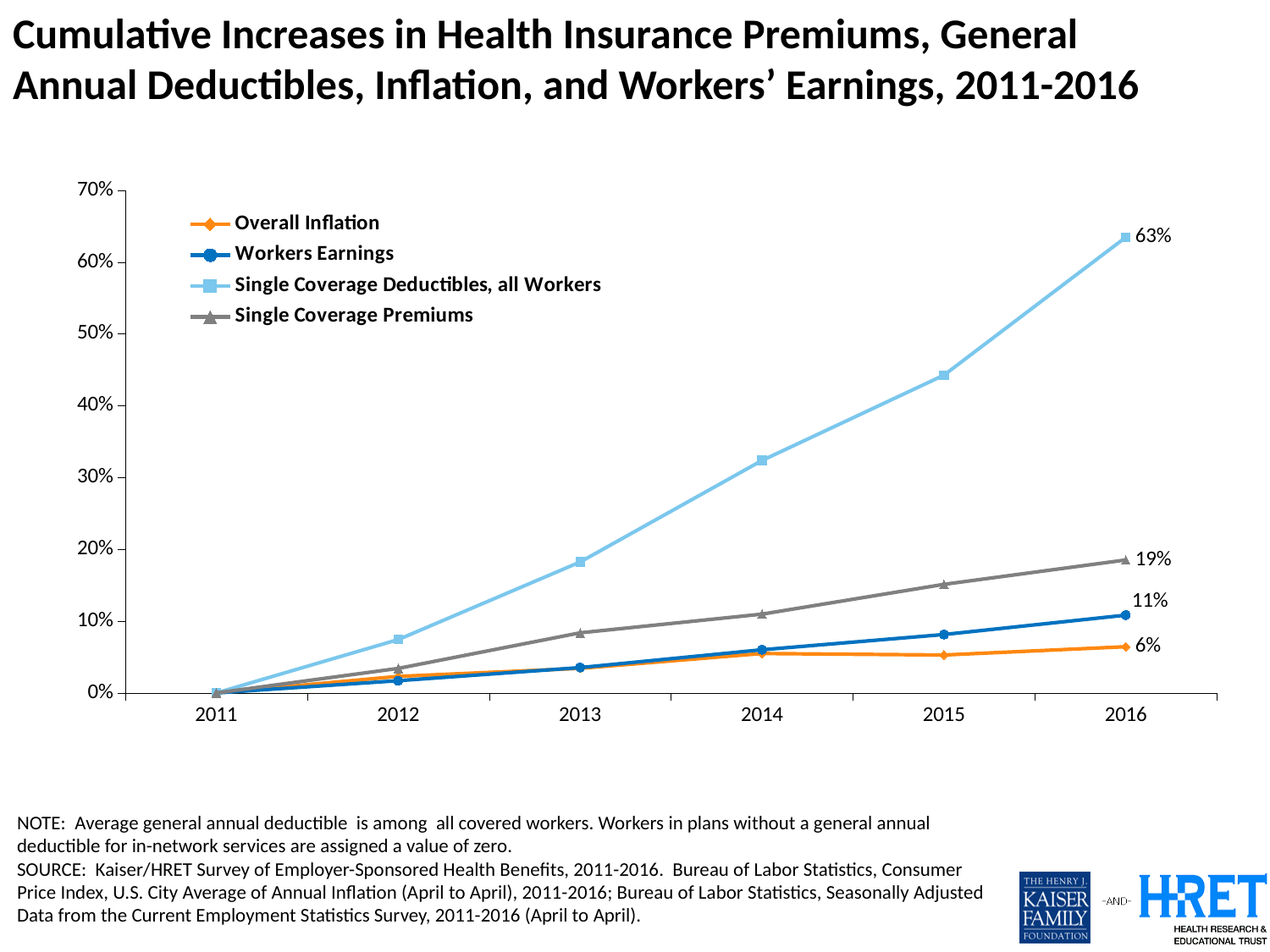
What is the cumulative increase for Single Coverage Deductibles, all Workers in 2016? 63% How many series does the legend list? 4 Which series has the highest value in 2016? Single Coverage Deductibles, all Workers What is the difference between the 2016 values for Single Coverage Deductibles, all Workers and Single Coverage Premiums? 44% What is the cumulative increase for Single Coverage Premiums in 2016? 19% What is the cumulative increase for Workers Earnings in 2016? 11% In 2016, which is larger: Workers Earnings or Overall Inflation? Workers Earnings Is the value for Single Coverage Deductibles, all Workers in 2015 greater or less than 40%? greater What kind of chart is shown on the slide? Line chart Which series has the lowest value in 2016? Overall Inflation Does the Single Coverage Deductibles, all Workers line rise or fall from 2011 to 2016? Rise What is the cumulative increase for Overall Inflation in 2016? 6%